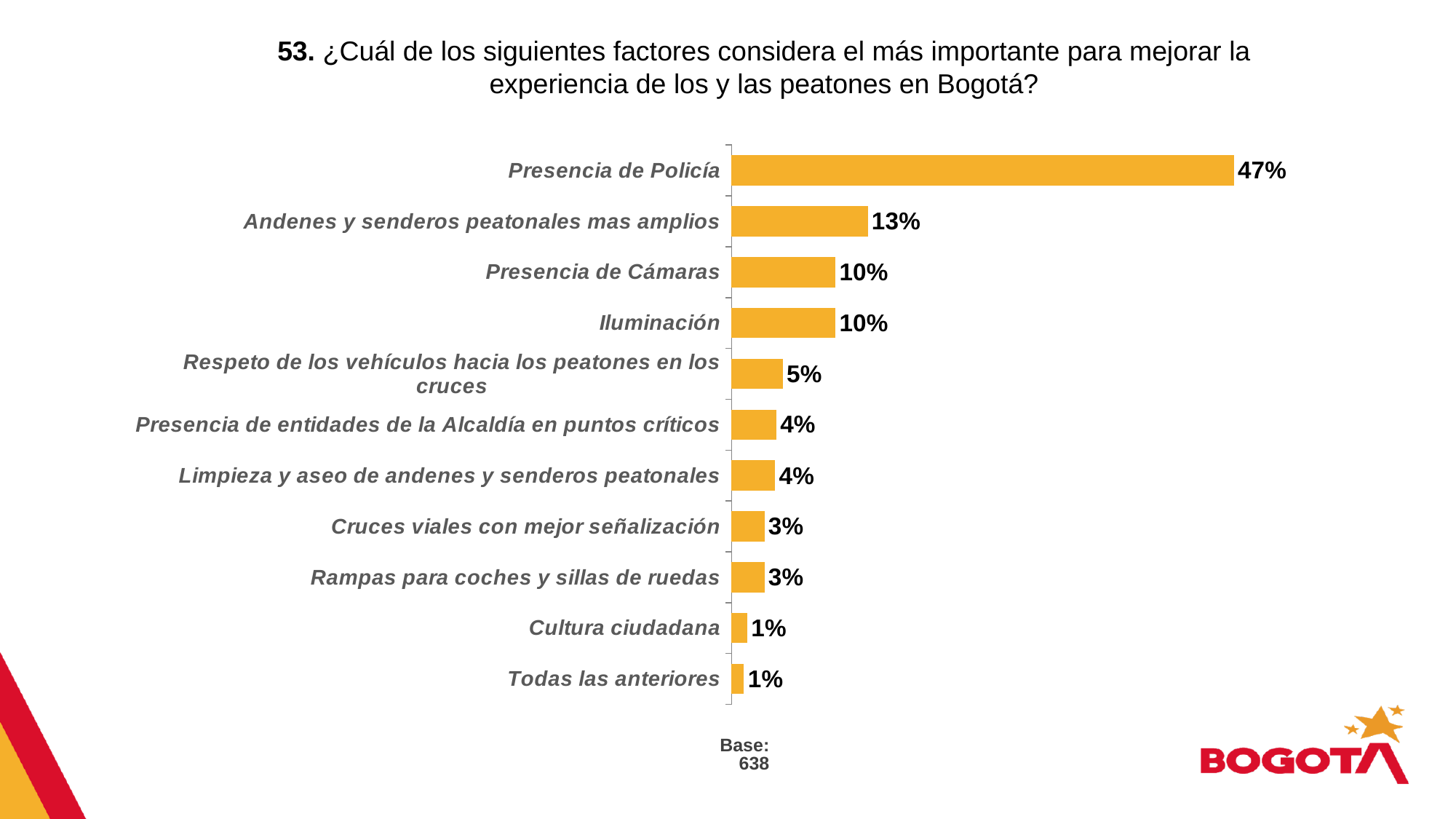
What is the difference between Presencia de Cámaras and Cruces viales con mejor señalización? 7% Which factor has the highest percentage? Presencia de Policía What percentage is shown for Iluminación? 10% Which is larger, Andenes y senderos peatonales mas amplios or Presencia de Cámaras? Andenes y senderos peatonales mas amplios What kind of chart is shown on the slide? Bar chart What is the difference between Presencia de Policía and Andenes y senderos peatonales mas amplios? 34% What is the value for Respeto de los vehículos hacia los peatones en los cruces? 5% What is the base (number of respondents) shown below the chart? 638 What percentage is shown for Presencia de Policía? 47% What percentage is shown for Cultura ciudadana? 1% How many factors (categories) are shown in the chart? 11 What is the value for Andenes y senderos peatonales mas amplios? 13%